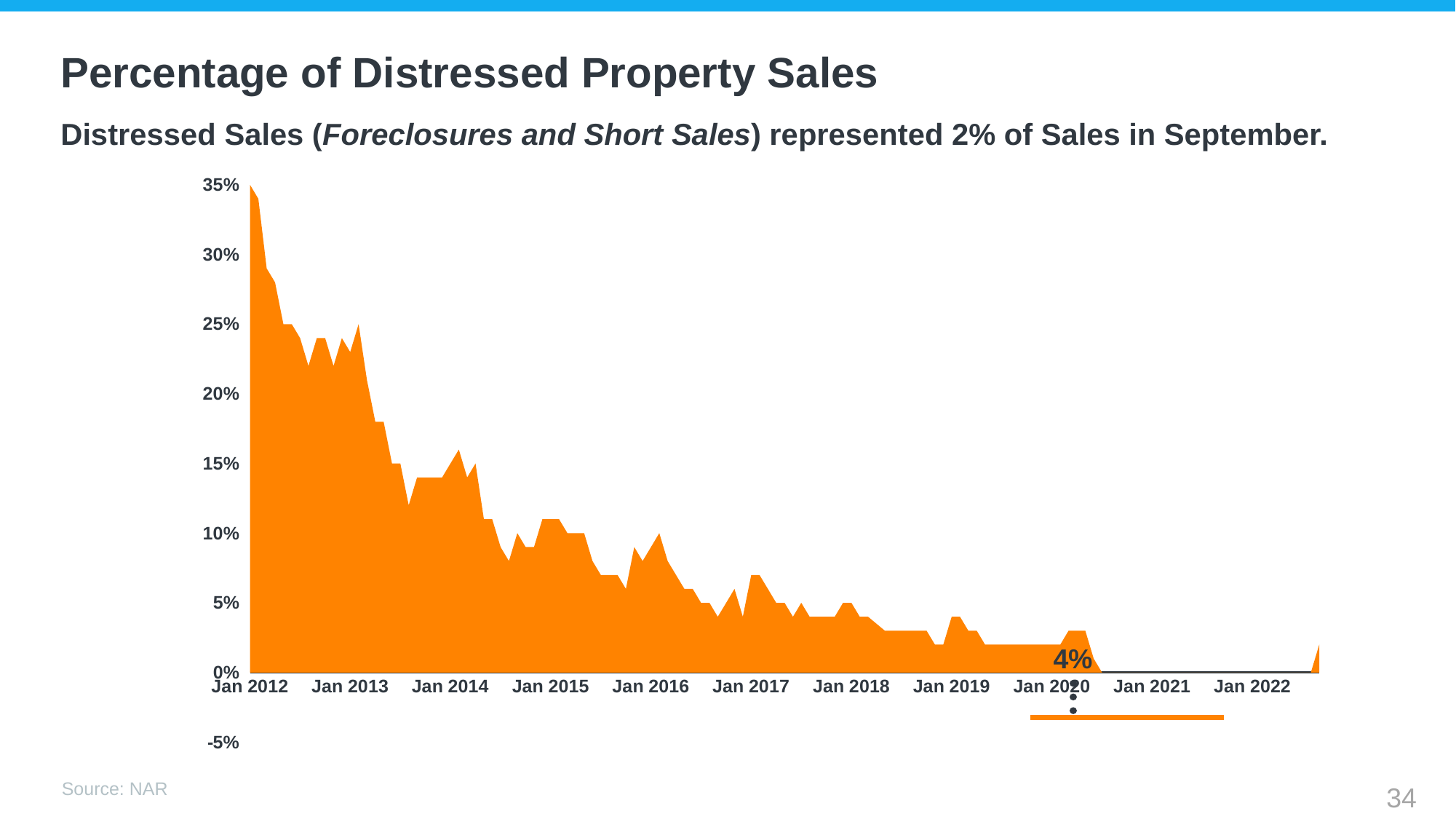
Which is larger, the value at Jan 2012 or the value at Jan 2016? Jan 2012 Do the values generally rise or fall from Jan 2012 to Jan 2022? fall Is the value at Jan 2013 greater or less than 20%? greater How many year labels are shown on the x axis? 11 At which x-axis label is the percentage of distressed property sales highest? Jan 2012 What is the source cited for the chart? NAR According to the slide, what percentage of sales did distressed sales represent in September? 2% What kind of chart is shown on the slide? area chart Is the value at Jan 2018 greater or less than 10%? less Is the value at Jan 2015 greater or less than 15%? less What is the title of the chart on the slide? Percentage of Distressed Property Sales